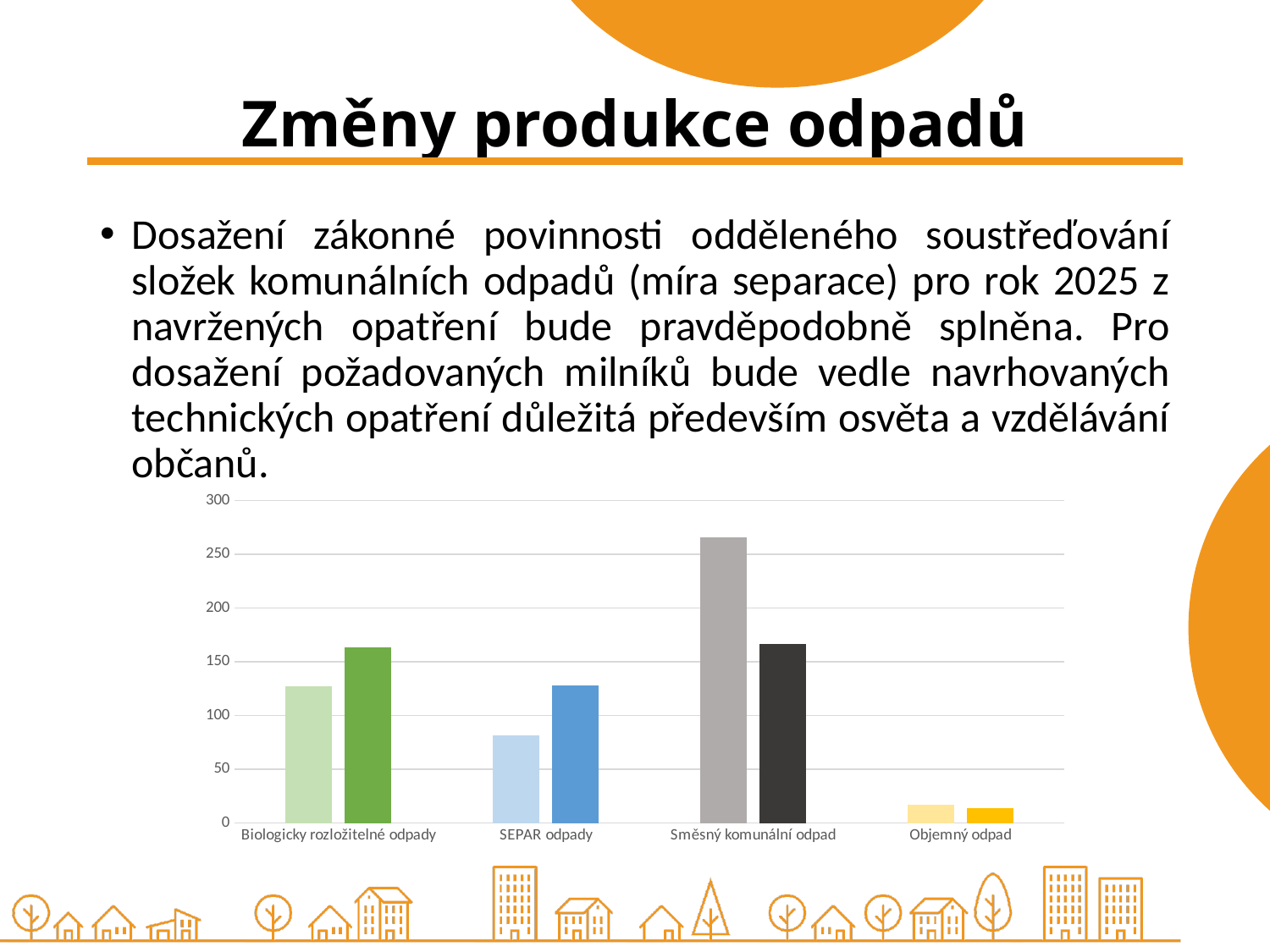
Which category has the tallest bar in the chart? Směsný komunální odpad For SEPAR odpady, which bar is larger: the lighter (light blue) bar or the darker (blue) bar? the darker (blue) bar How many bars are plotted for each category in the chart? 2 Is the value of the lighter (light blue) bar for SEPAR odpady greater or less than 100? less Which category has the lowest bars in the chart? Objemný odpad Is the value of the darker (black) bar for Směsný komunální odpad greater or less than 200? less Is the value of the darker (green) bar for Biologicky rozložitelné odpady greater or less than 150? greater What kind of chart is shown on the slide? bar chart For Směsný komunální odpad, which bar is larger: the lighter (grey) bar or the darker (black) bar? the lighter (grey) bar How many categories are shown on the x axis of the chart? 4